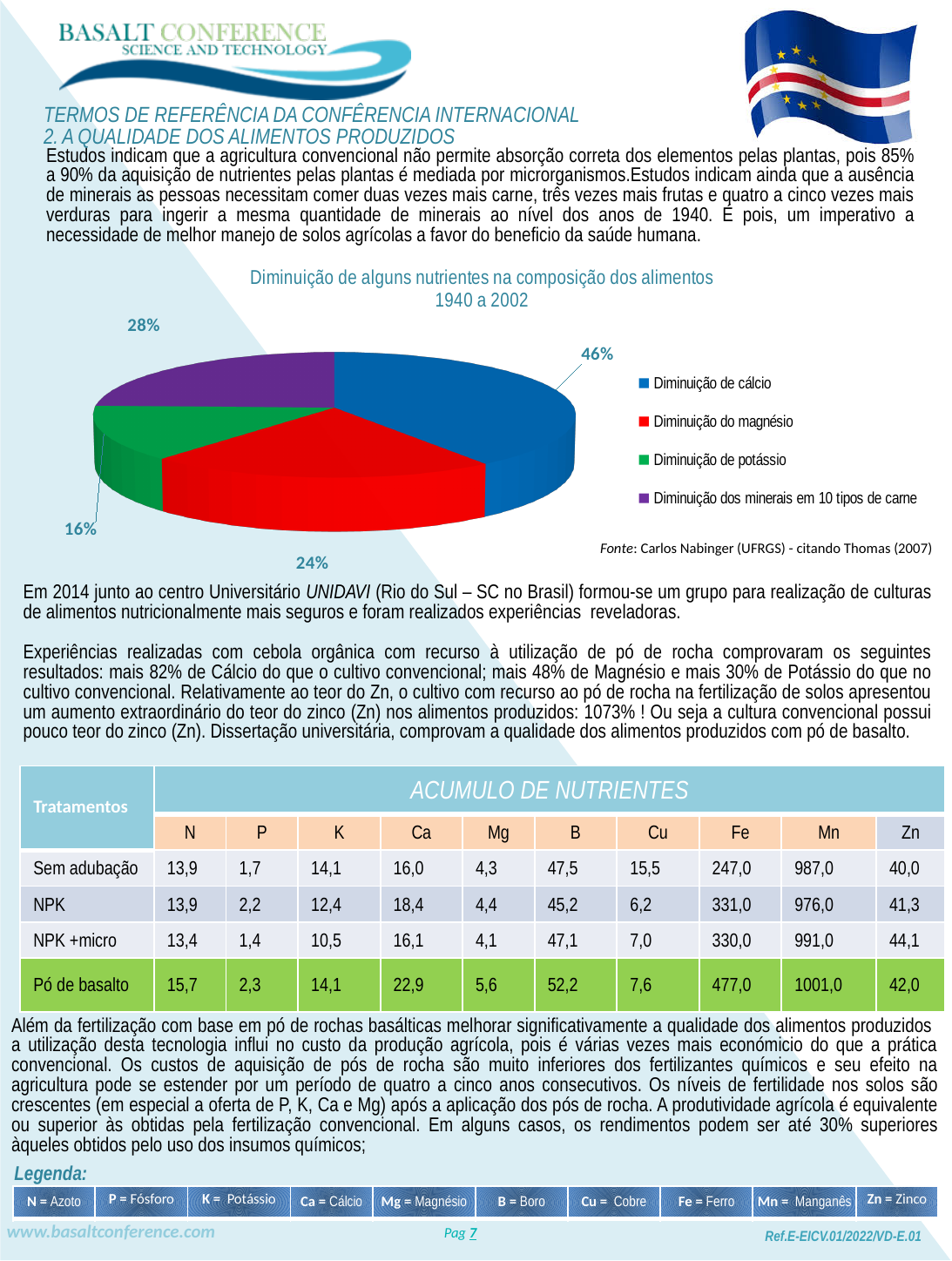
What value is shown for 'Diminuição de potássio' in the pie chart? 16% What value is shown for 'Diminuição dos minerais em 10 tipos de carne' in the pie chart? 28% What value is shown for 'Diminuição do magnésio' in the pie chart? 24% Which is larger in the pie chart: 'Diminuição dos minerais em 10 tipos de carne' or 'Diminuição do magnésio'? Diminuição dos minerais em 10 tipos de carne Which category has the largest value in the pie chart? Diminuição de cálcio Which category has the smallest value in the pie chart? Diminuição de potássio What is the difference between the values for 'Diminuição de cálcio' and 'Diminuição do magnésio'? 22% Which colour represents 'Diminuição de potássio' in the pie chart? green What is the title of the pie chart? Diminuição de alguns nutrientes na composição dos alimentos 1940 a 2002 What value is shown for 'Diminuição de cálcio' in the pie chart? 46% How many slices does the pie chart have? 4 What kind of chart is shown on the slide? pie chart